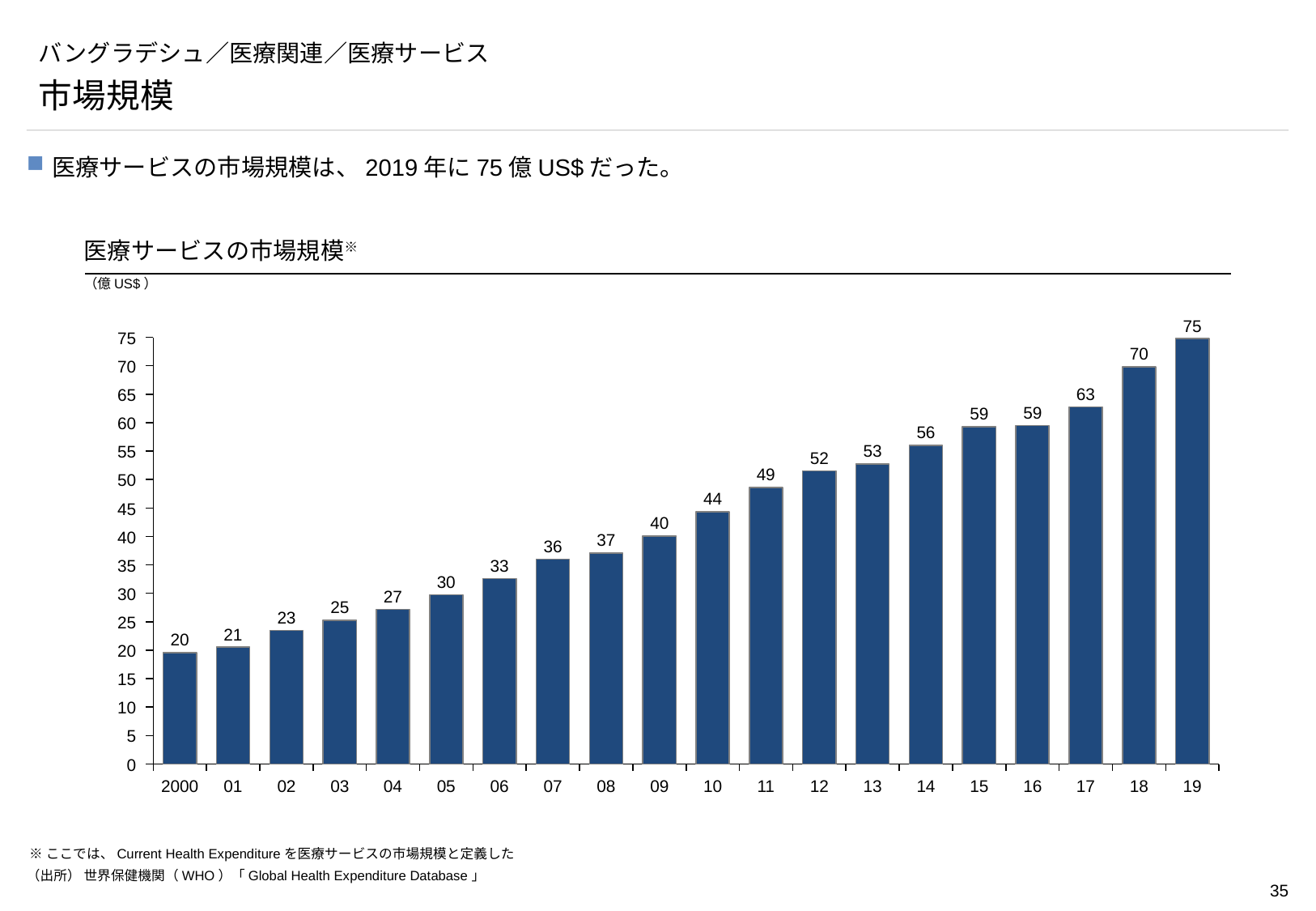
What is the difference between the values for 2018 and 2017? 7 Which year has the lowest value? 2000 Which is larger, the value for 2011 or the value for 2012? 2012 What is the value for 2010? 44 What unit is shown for the y axis? 億US$ What is the difference between the values for 2019 and 2000? 55 How many bars are plotted in the chart? 20 Which year has the highest value? 19 What kind of chart is shown? Bar chart What is the value for 2000? 20 Do the values rise or fall from 2000 to 2019? Rise What is the value for 2019? 75